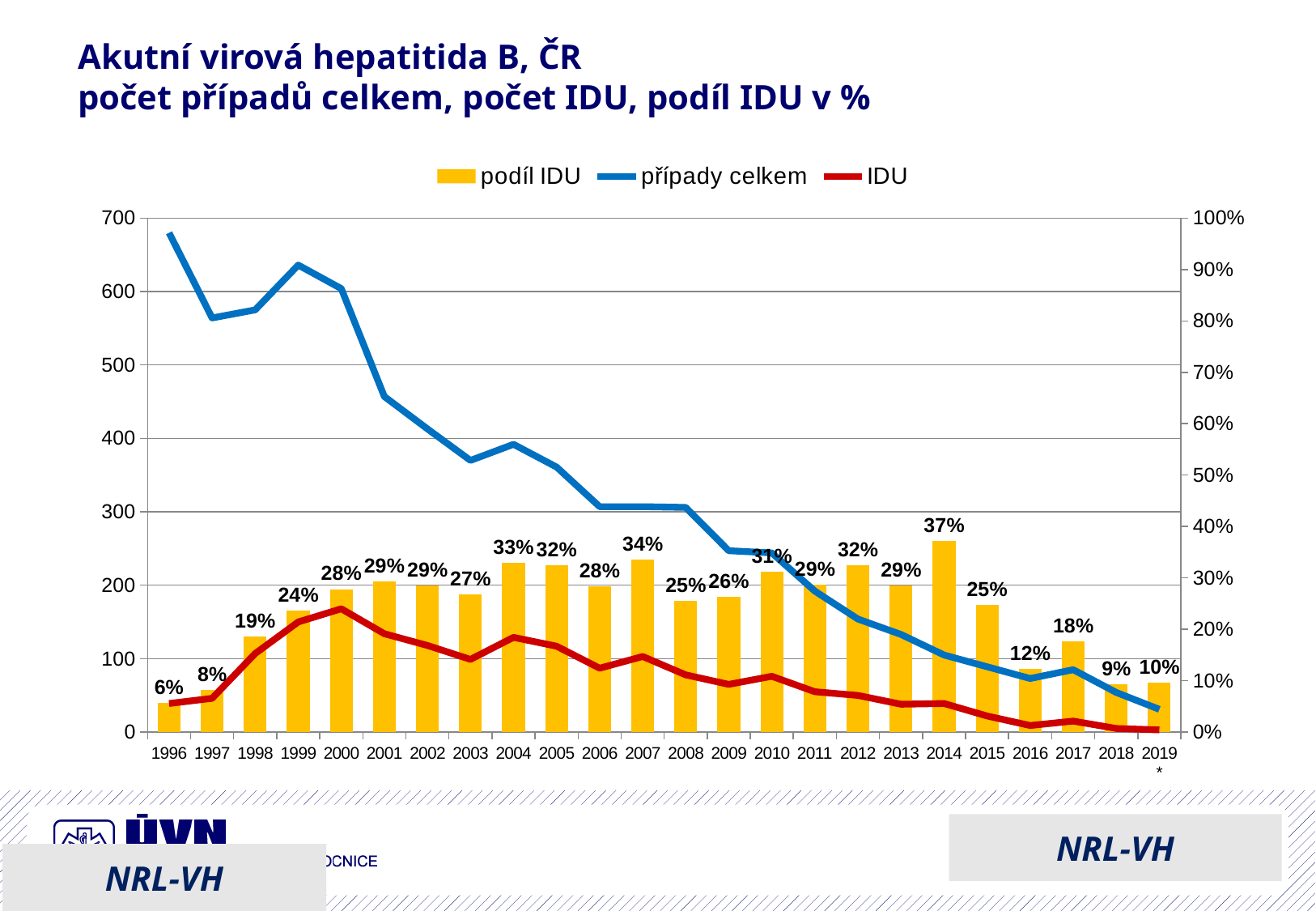
How many series does the legend list? 3 What is the podíl IDU value for 2007? 34% What is the difference between the podíl IDU values for 2014 and 2015? 12% Which year has a larger podíl IDU, 2004 or 2008? 2004 Which year has the lowest podíl IDU? 1996 What is the podíl IDU value for 2014? 37% How many years are shown on the x axis? 24 Is the value of případy celkem for 2019 greater or less than 100? less Does the případy celkem line generally rise or fall from 1996 to 2019? fall Which year has the highest podíl IDU? 2014 What is the podíl IDU value for 1996? 6% Is the value of případy celkem for 1996 greater or less than 600? greater